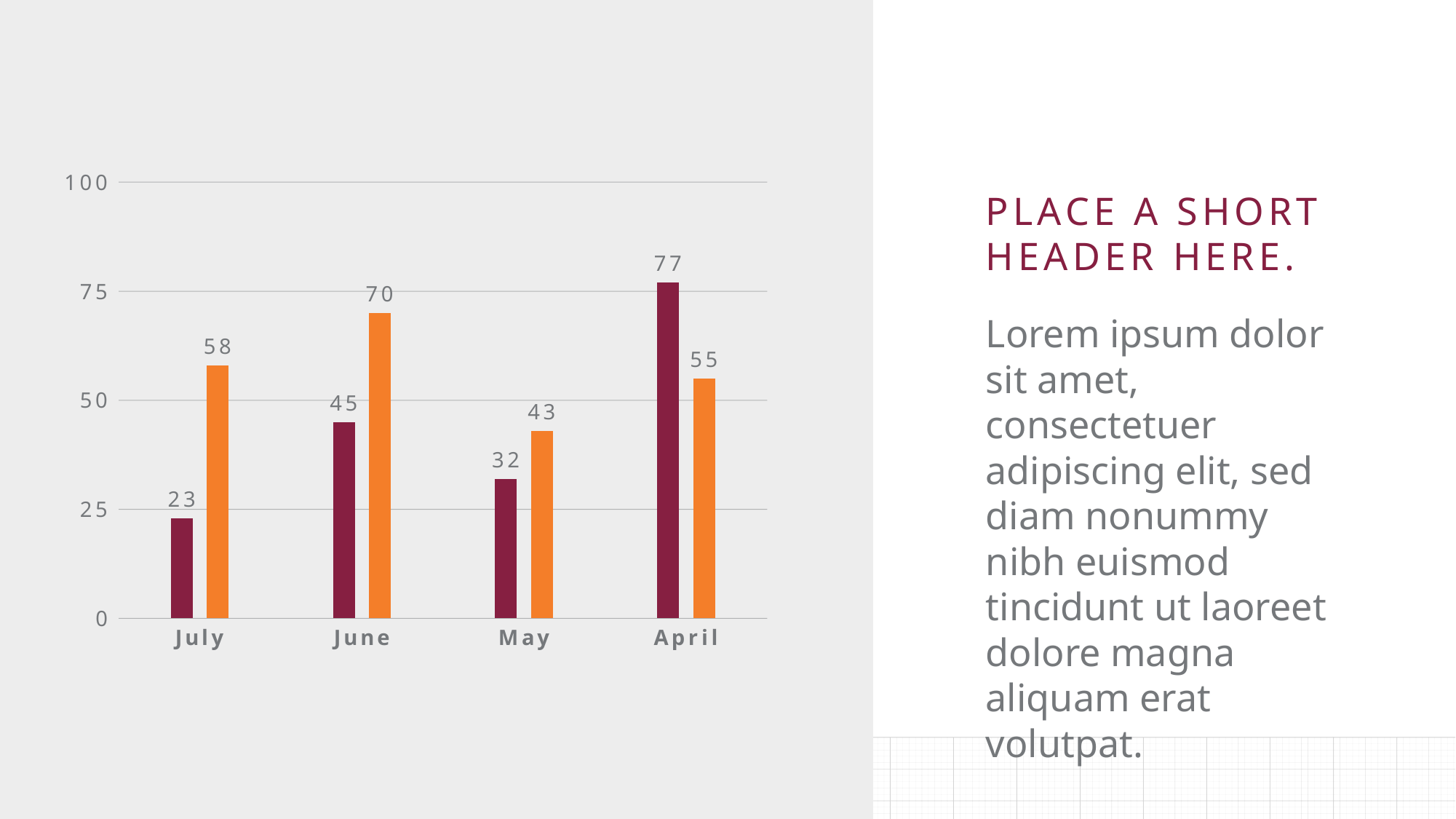
Which month has the highest orange bar? June What kind of chart is shown on the slide? bar chart Is the value of the dark red bar for May greater or less than 50? less What is the difference between the orange and dark red bars for July? 35 What is the value of the orange bar for May? 43 What is the highest value shown on the y axis? 100 Which month has the lowest dark red bar? July Which is larger for April, the dark red bar or the orange bar? the dark red bar What is the value of the dark red bar for April? 77 What is the value of the orange bar for June? 70 How many months are shown on the x axis? 4 What is the value of the dark red bar for July? 23